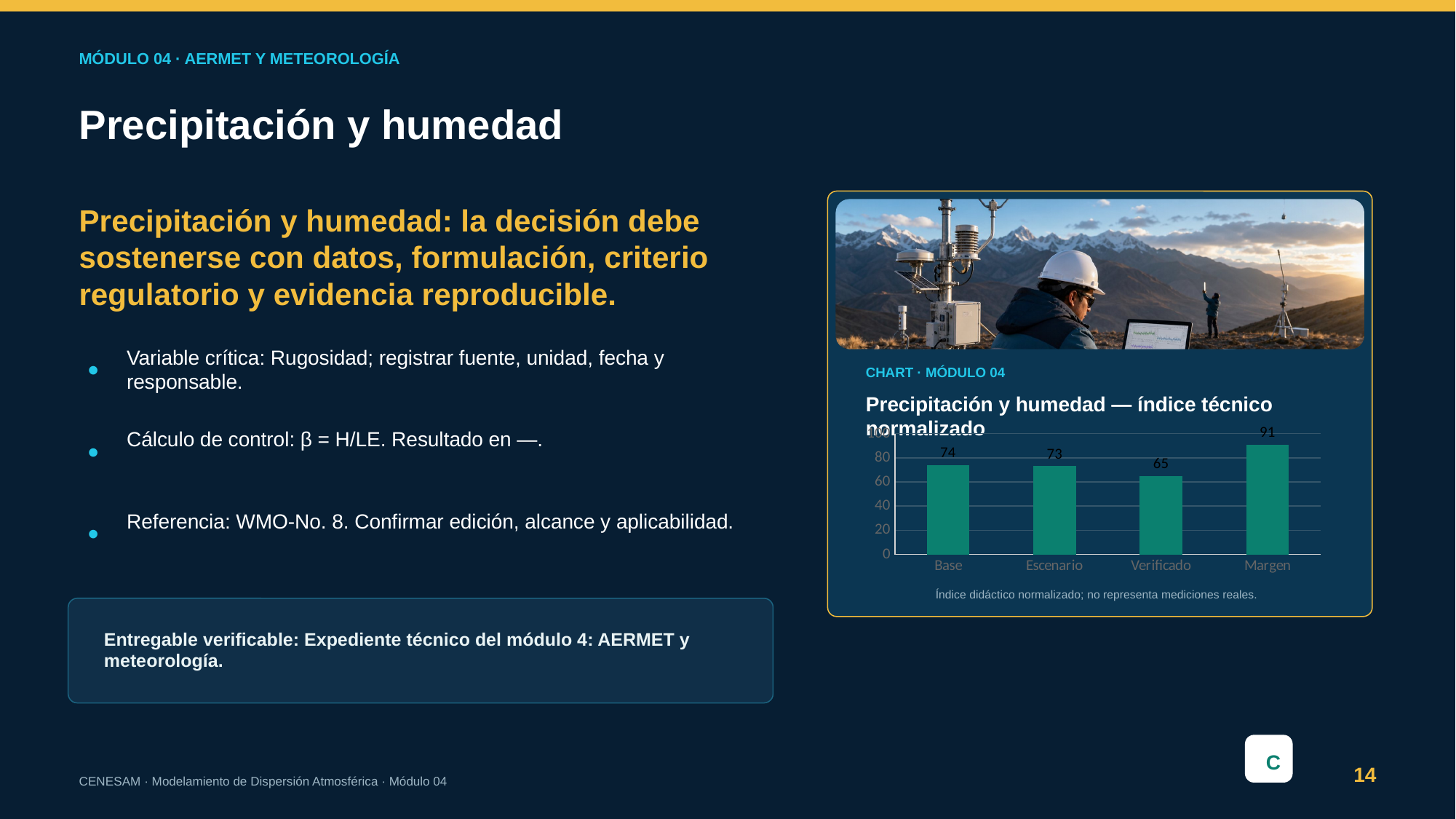
What is the value for Escenario? 73 How many categories are shown on the x axis? 4 What is the difference between the values for Margen and Verificado? 26 Is the value for Margen greater or less than 80? greater Which category has the highest value? Margen What is the title of the chart? Precipitación y humedad — índice técnico normalizado Which category has the lowest value? Verificado What is the value for Margen? 91 What is the value for Base? 74 What kind of chart is shown? bar chart Which is larger, the value for Base or the value for Verificado? Base What is the value for Verificado? 65